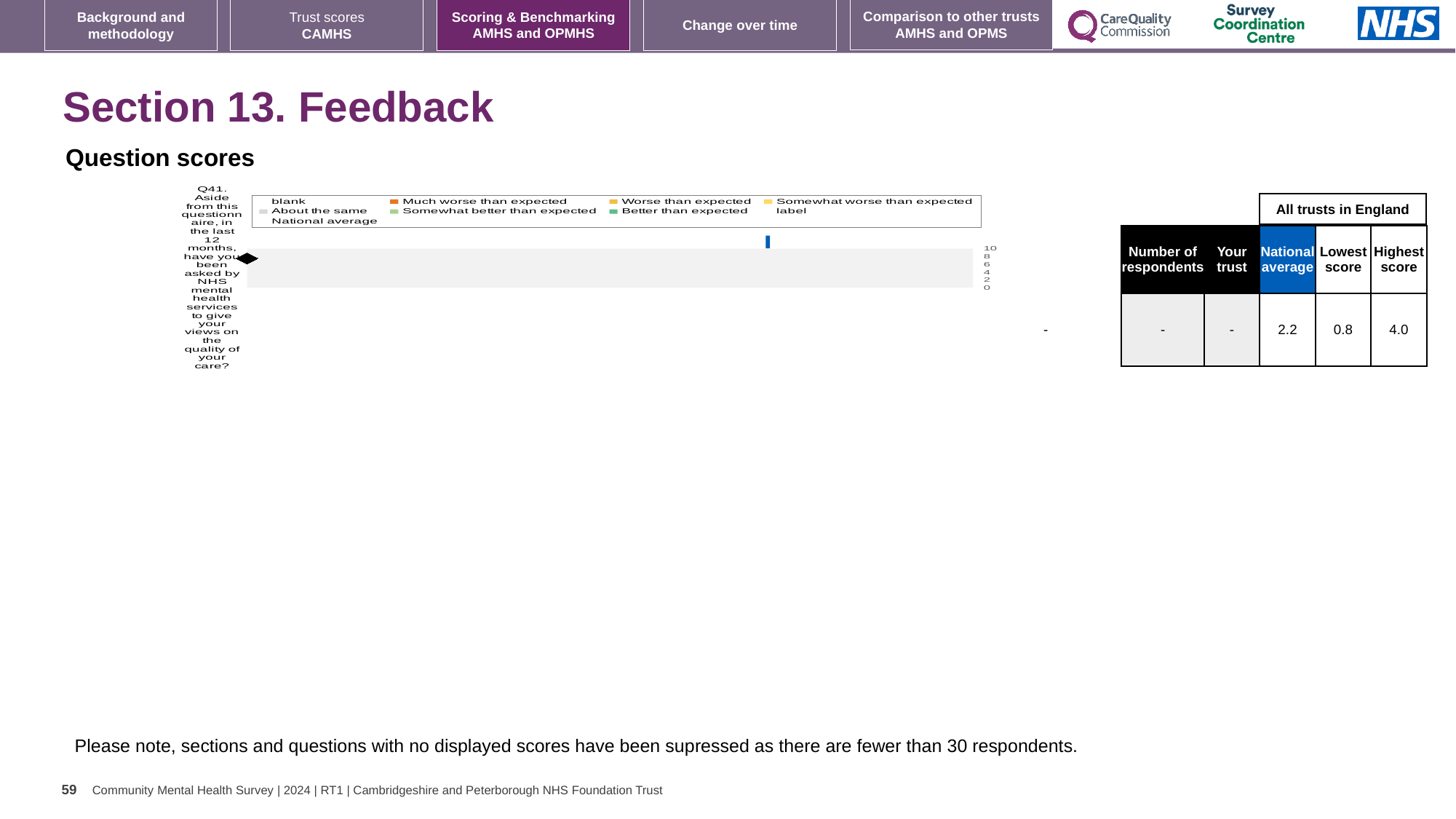
What colour is the 'Much worse than expected' legend entry? Orange What is the difference between the highest score and the national average shown for Q41? 1.8 What value is shown for 'Your trust' for Q41 in the table? - What kind of chart is shown on the slide? Bar chart What is the lowest score across all trusts in England shown for Q41? 0.8 Is the national average for Q41 greater or less than 4? less What is the difference between the highest score and the lowest score shown for Q41? 3.2 How many questions (categories) are plotted on the chart? 1 Which is larger for Q41, the national average or the lowest score? National average What is the highest value shown on the chart's numeric axis? 10 What is the national average score shown for Q41 in the table? 2.2 What is the highest score across all trusts in England shown for Q41? 4.0